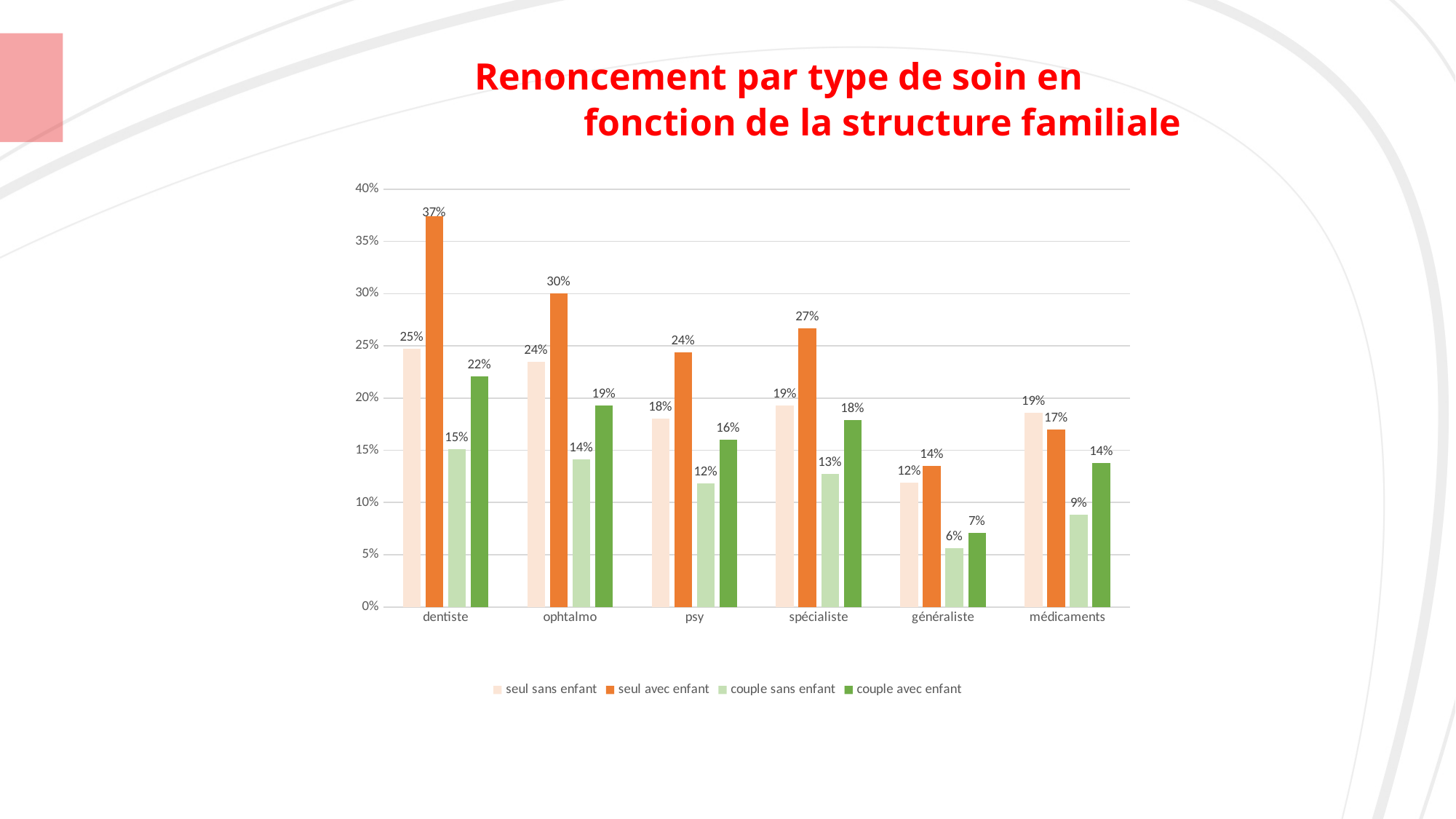
What kind of chart is shown on the slide? bar chart What is the value for 'seul avec enfant' in the 'dentiste' category? 37% How many series does the legend list? 4 What is the value for 'couple sans enfant' in the 'généraliste' category? 6% How many categories are shown on the x axis? 6 What is the difference between 'seul avec enfant' and 'couple sans enfant' in the 'ophtalmo' category? 16% What is the title of the chart on the slide? Renoncement par type de soin en fonction de la structure familiale Which category has the highest value for the 'seul avec enfant' series? dentiste In the 'médicaments' category, which is larger: 'seul sans enfant' or 'seul avec enfant'? seul sans enfant What is the value for 'couple avec enfant' in the 'médicaments' category? 14% Which category has the lowest value for the 'couple sans enfant' series? généraliste Is the value for 'seul avec enfant' in the 'spécialiste' category greater or less than 25%? greater